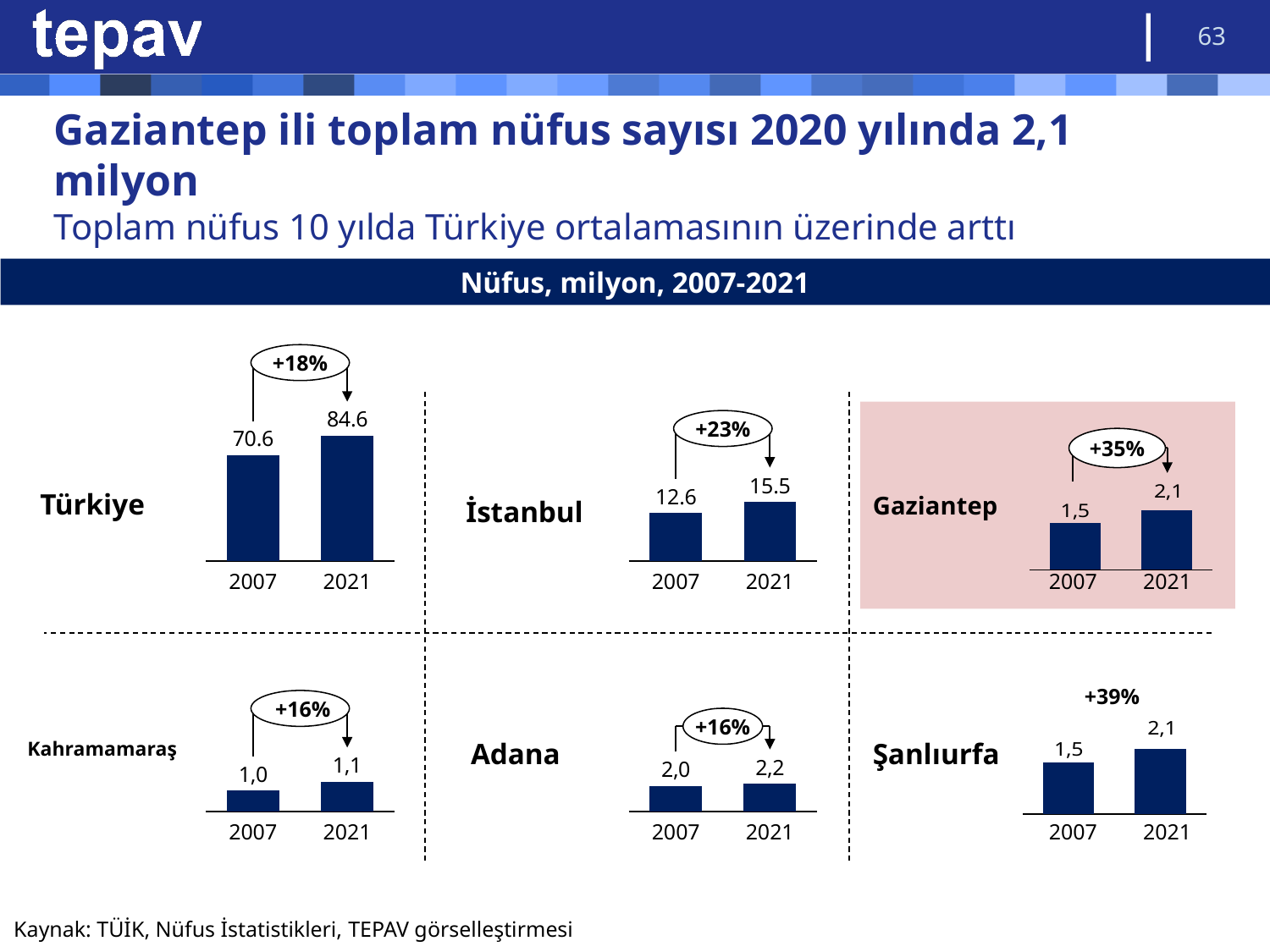
In the Şanlıurfa chart, do the values rise or fall from 2007 to 2021? rise What percentage change is annotated on the Gaziantep chart? +35% In the İstanbul chart, what is the population value shown for 2007? 12.6 In the İstanbul chart, what is the difference between the 2021 and 2007 values? 2.9 In the Gaziantep chart, what is the population value shown for 2021? 2,1 In the Adana chart, what is the population value shown for 2007? 2,0 In the Türkiye chart, what is the difference between the 2021 and 2007 values? 14.0 What kind of chart is used for Gaziantep? bar chart In the Türkiye chart, what is the population value shown for 2021? 84.6 How many bars are plotted in the Adana chart? 2 What percentage change is annotated on the Şanlıurfa chart? +39% In the Kahramanmaraş chart, which year has the higher value, 2007 or 2021? 2021